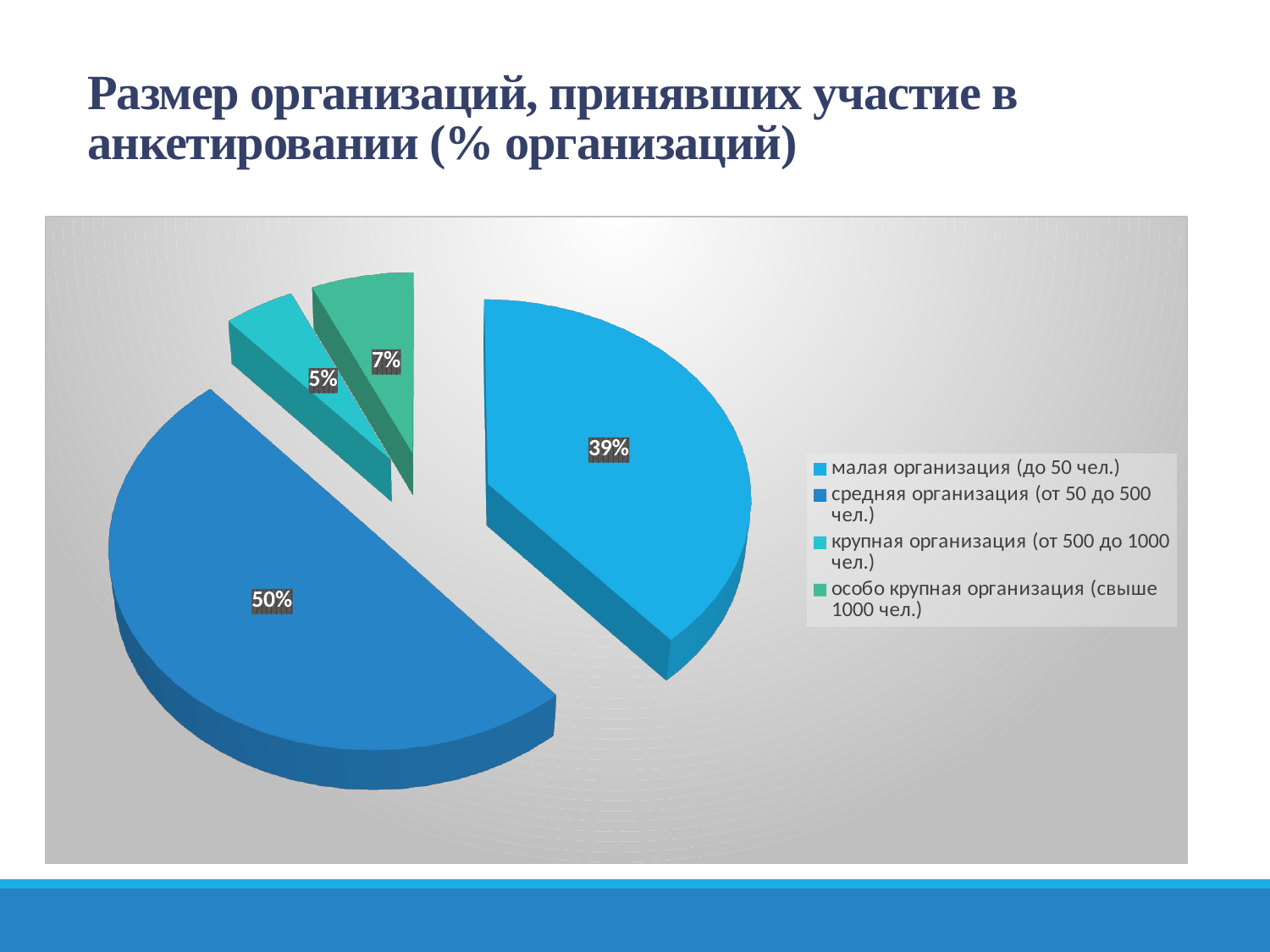
What share of the pie does особо крупная организация (свыше 1000 чел.) have? 7% Which is larger: the share for особо крупная организация (свыше 1000 чел.) or for крупная организация (от 500 до 1000 чел.)? особо крупная организация (свыше 1000 чел.) How many categories does the pie chart show? 4 What colour is the slice for особо крупная организация (свыше 1000 чел.)? green Which category has the smallest slice of the pie? крупная организация (от 500 до 1000 чел.) What share of the pie does средняя организация (от 50 до 500 чел.) have? 50% Which category has the largest slice of the pie? средняя организация (от 50 до 500 чел.) What is the title of the slide? Размер организаций, принявших участие в анкетировании (% организаций) What is the difference in percentage points between средняя организация (от 50 до 500 чел.) and малая организация (до 50 чел.)? 11 What share of the pie does крупная организация (от 500 до 1000 чел.) have? 5% What kind of chart is shown on the slide? pie chart What share of the pie does малая организация (до 50 чел.) have? 39%